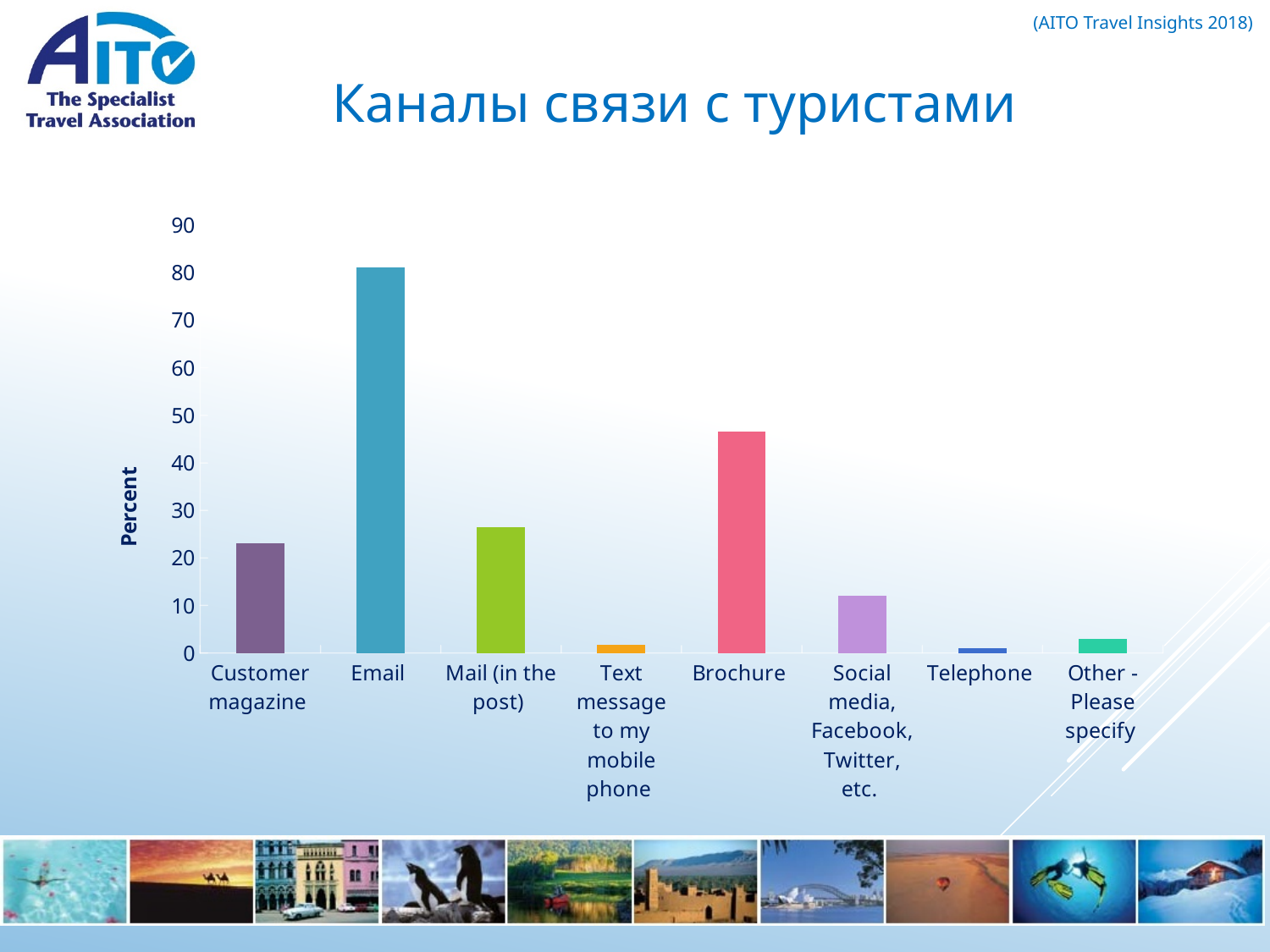
Is the value for Email greater or less than 70? greater Is the value for Mail (in the post) greater or less than 30? less Which communication channel has the highest percentage? Email What kind of chart is shown on the slide? bar chart Is the value for Brochure greater or less than 50? less Which is larger, the value for Customer magazine or the value for Social media, Facebook, Twitter, etc.? Customer magazine Which is larger, the value for Brochure or the value for Mail (in the post)? Brochure What is the label on the vertical axis of the chart? Percent How many communication channels (categories) are shown on the x axis? 8